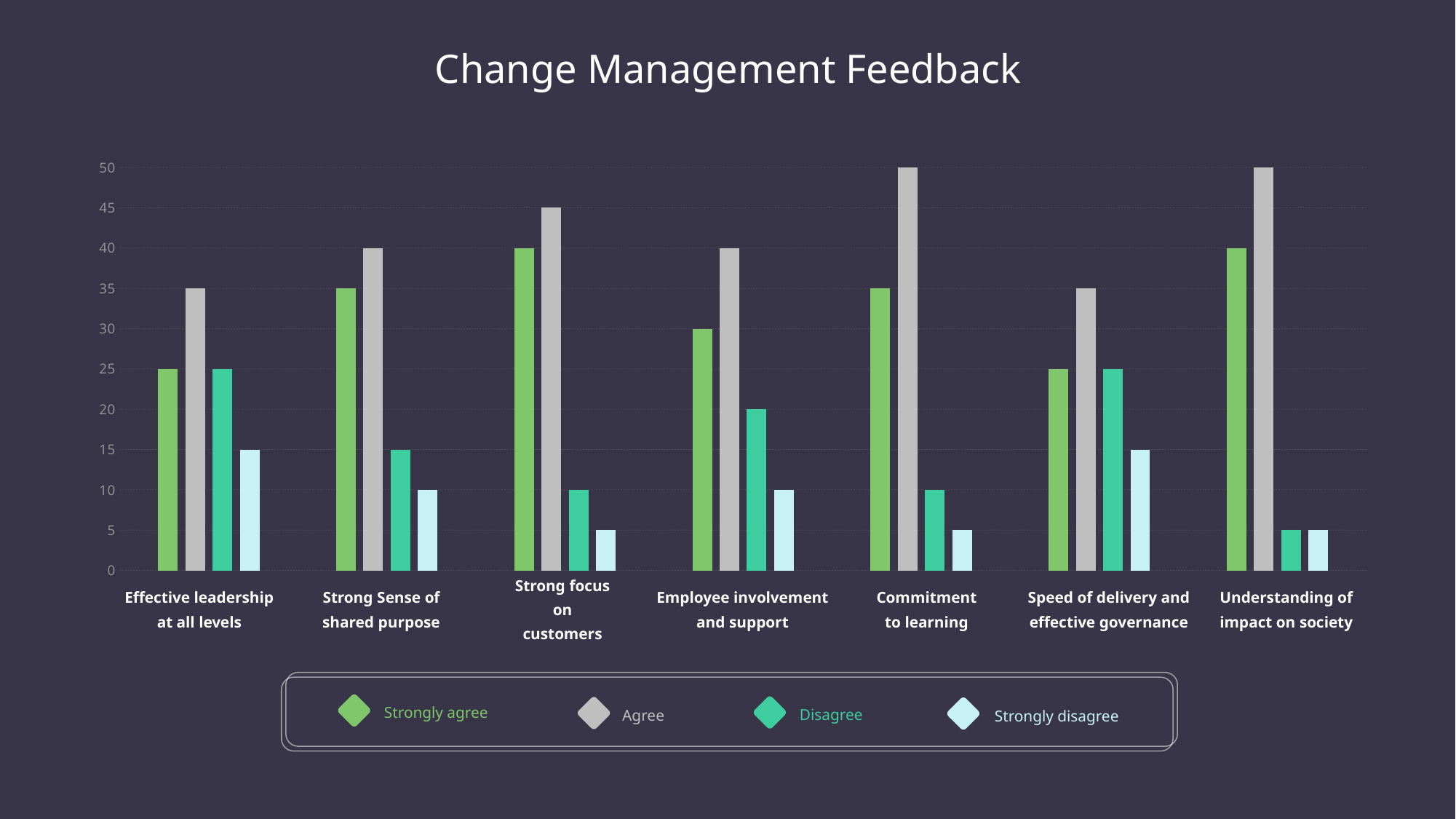
How many categories are shown on the x axis? 7 What is the Strongly agree value for Employee involvement and support? 30 What is the title of the chart? Change Management Feedback What is the difference between the Agree and Strongly agree values for Strong Sense of shared purpose? 5 What is the Strongly disagree value for Strong focus on customers? 5 How many series does the legend list? 4 Is the Agree value for Understanding of impact on society greater or less than 45? greater What is the Agree value for Commitment to learning? 50 Which category has the highest Strongly agree value? Strong focus on customers and Understanding of impact on society What kind of chart is shown on the slide? bar chart Which category has the lowest Disagree value? Understanding of impact on society Which is larger for Effective leadership at all levels: the Agree value or the Disagree value? Agree